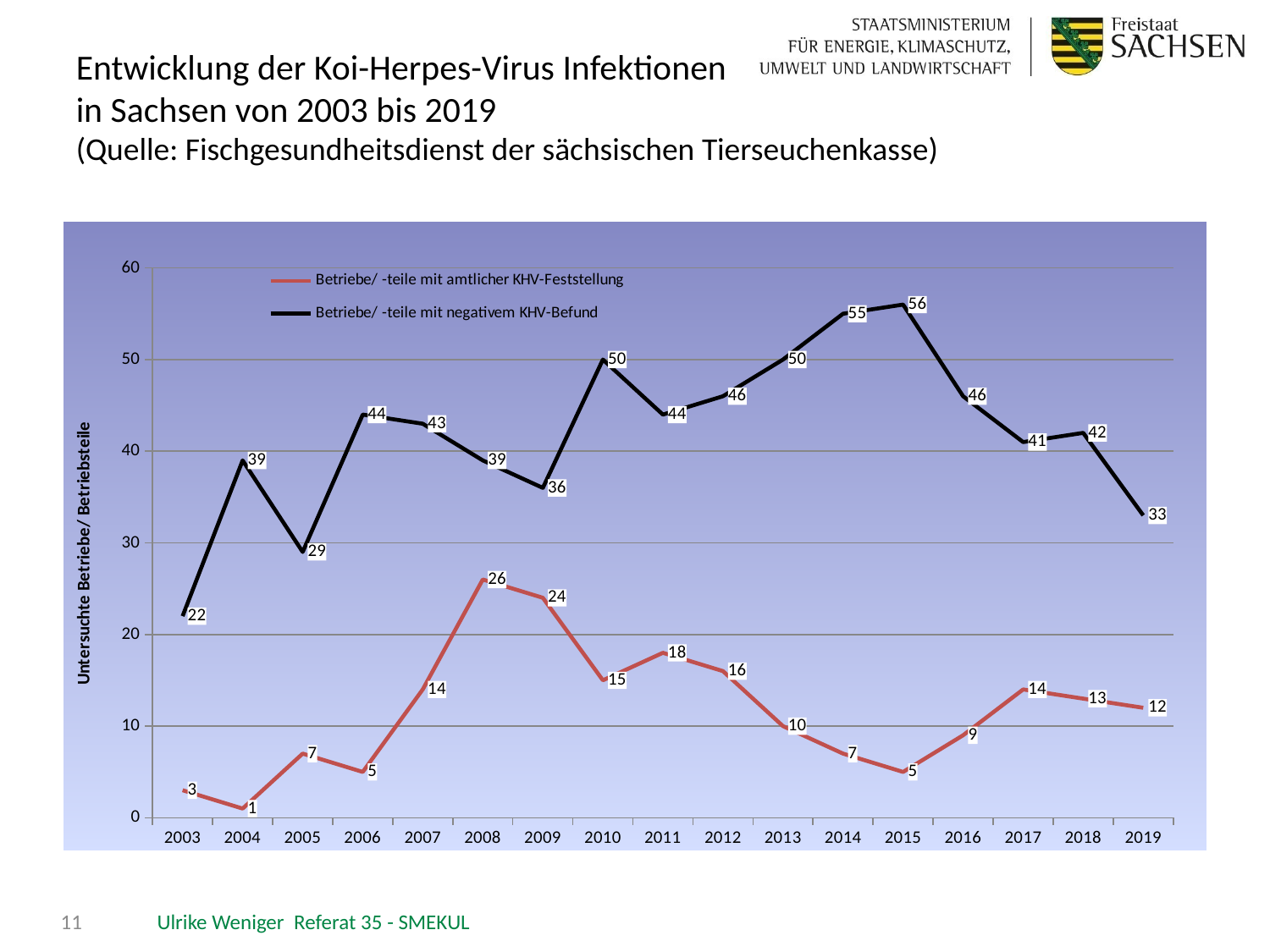
Does 'Betriebe/ -teile mit negativem KHV-Befund' rise or fall from 2015 to 2019? fall In which year is 'Betriebe/ -teile mit amtlicher KHV-Feststellung' lowest? 2004 Which is larger: 'Betriebe/ -teile mit negativem KHV-Befund' in 2005 or in 2006? 2006 What is the value for 'Betriebe/ -teile mit amtlicher KHV-Feststellung' in 2008? 26 In which year is 'Betriebe/ -teile mit amtlicher KHV-Feststellung' highest? 2008 What is the value for 'Betriebe/ -teile mit negativem KHV-Befund' in 2003? 22 In which year is 'Betriebe/ -teile mit negativem KHV-Befund' highest? 2015 What is the difference between the two series in 2010? 35 What is the value for 'Betriebe/ -teile mit negativem KHV-Befund' in 2015? 56 How many years are shown on the x axis? 17 How many series does the legend list? 2 What kind of chart is shown? line chart